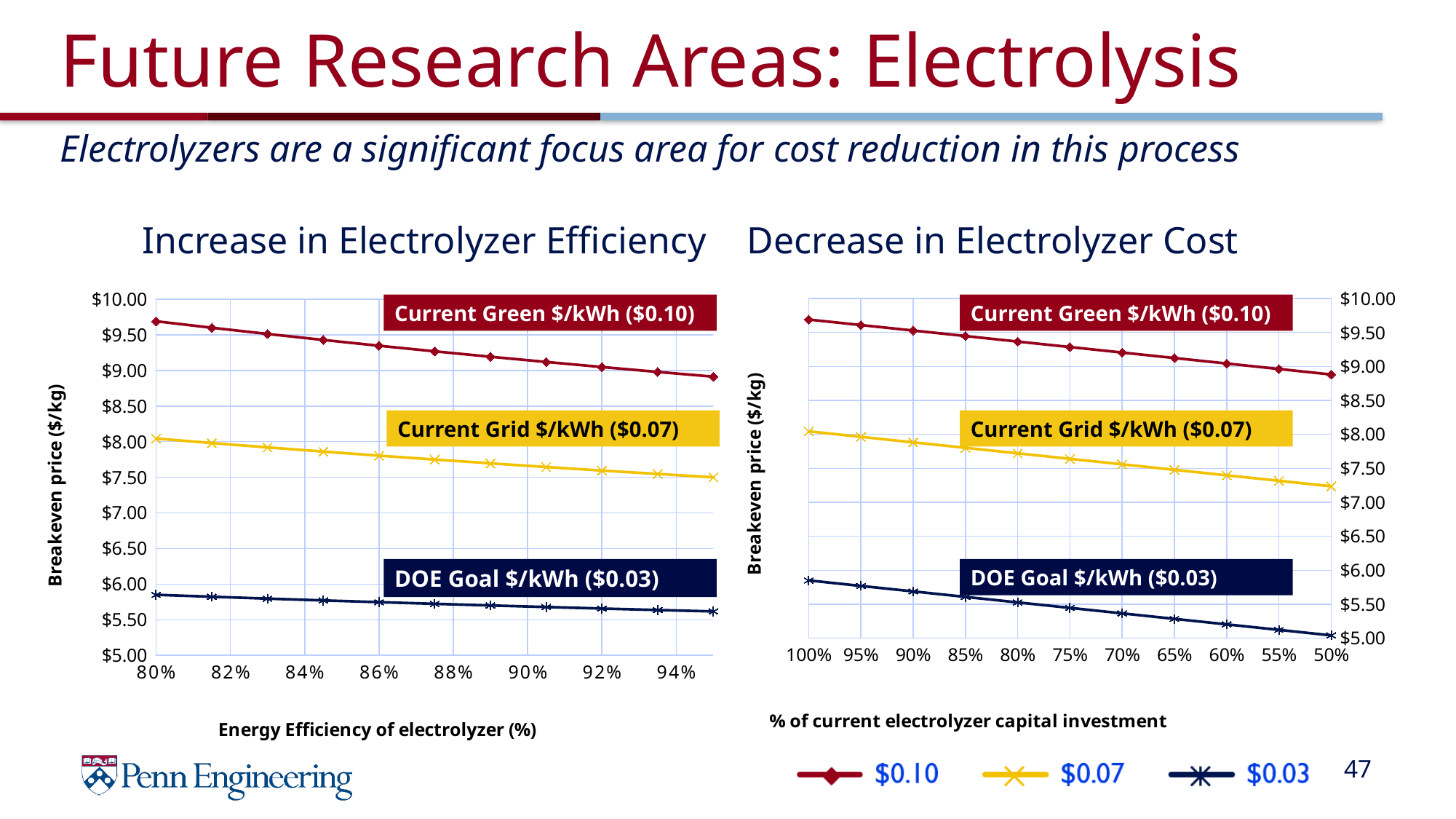
In the "Increase in Electrolyzer Efficiency" chart, is the value for the $0.10 series at 80% greater or less than $9.50? greater In the "Increase in Electrolyzer Efficiency" chart, is the value for the $0.03 series at 80% greater or less than $6.00? less In the "Decrease in Electrolyzer Cost" chart, is the value for the $0.07 series at 50% greater or less than $7.50? less What is the x-axis label of the "Decrease in Electrolyzer Cost" chart? % of current electrolyzer capital investment What kind of chart is the "Increase in Electrolyzer Efficiency" chart? line chart In the "Increase in Electrolyzer Efficiency" chart, does the breakeven price for the $0.10 series rise or fall as energy efficiency increases? fall How many series does the legend at the bottom of the slide list? 3 In the "Decrease in Electrolyzer Cost" chart, which series has the lowest breakeven price? $0.03 In the "Decrease in Electrolyzer Cost" chart, how many x-axis categories are plotted? 11 In the "Decrease in Electrolyzer Cost" chart, at 50%, which series has the larger breakeven price, $0.07 or $0.03? $0.07 In the "Increase in Electrolyzer Efficiency" chart, which series has the highest breakeven price? $0.10 In the "Decrease in Electrolyzer Cost" chart, does the $0.03 series rise or fall moving from 100% to 50% along the x axis? fall